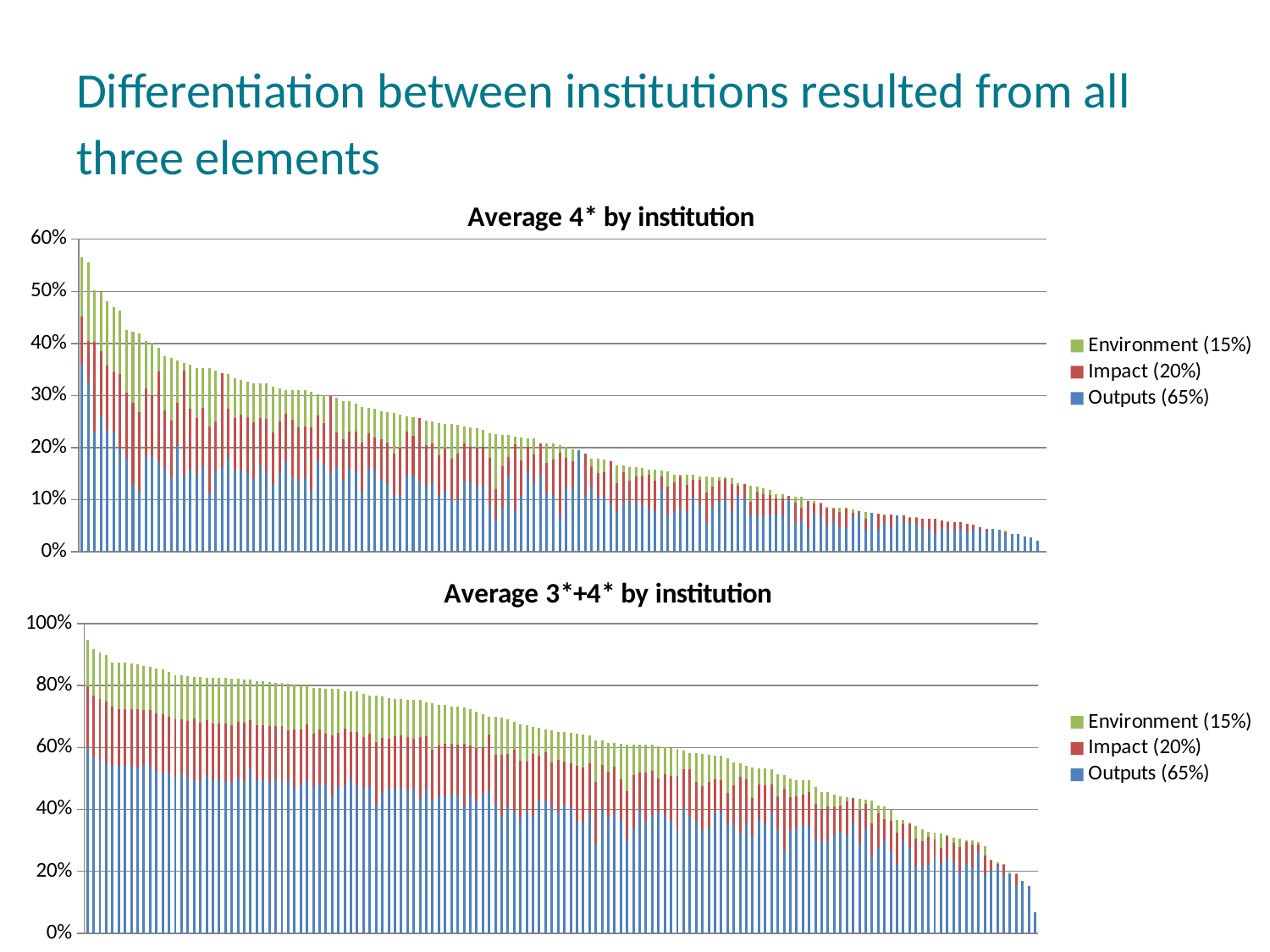
In the 'Average 4* by institution' chart, is the total of the shortest (rightmost) bar greater or less than 10%? less How many series does the legend of the 'Average 4* by institution' chart list? 3 What kind of chart is the 'Average 3*+4* by institution' chart? Stacked bar chart How many series does the legend of the 'Average 3*+4* by institution' chart list? 3 Which legend entry in the 'Average 4* by institution' chart is shown in green? Environment (15%) In the 'Average 4* by institution' chart, do the stacked bar totals rise or fall from left to right? Fall What kind of chart is the 'Average 4* by institution' chart? Stacked bar chart In the 'Average 4* by institution' chart, is the total of the tallest (leftmost) bar greater or less than 50%? greater In the 'Average 3*+4* by institution' chart, is the total of the tallest (leftmost) bar greater or less than 90%? greater What is the highest value shown on the y axis of the 'Average 3*+4* by institution' chart? 100% In the 'Average 3*+4* by institution' chart, do the stacked bar totals rise or fall from left to right? Fall